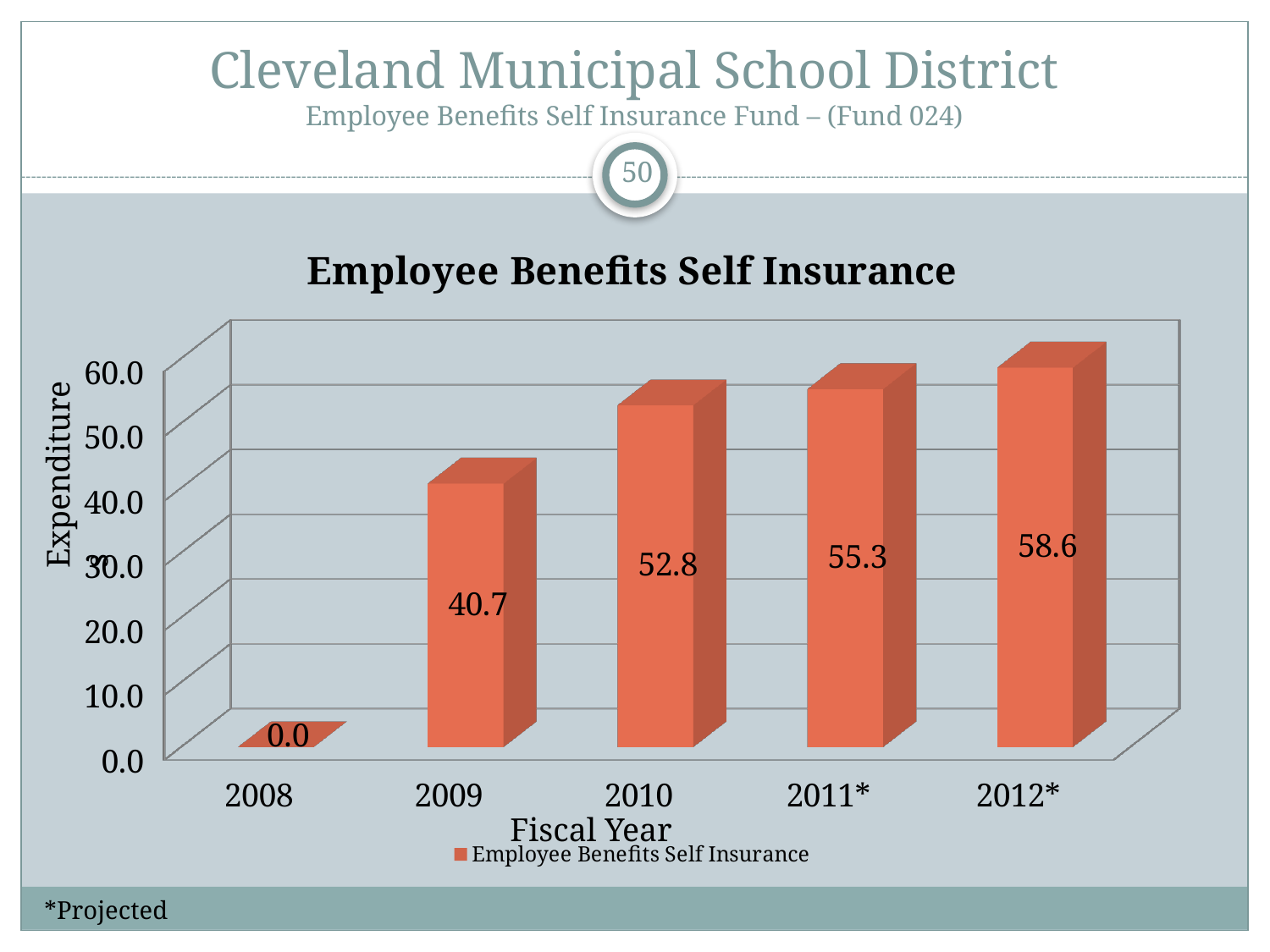
What is the expenditure value for fiscal year 2010? 52.8 Is the value for 2009 greater or less than 50.0? less How many series does the legend list? 1 What kind of chart is shown on the slide? bar chart What is the expenditure value for fiscal year 2009? 40.7 Which fiscal year has the lowest expenditure? 2008 Which is larger, the expenditure for 2009 or for 2011*? 2011* What is the expenditure value for fiscal year 2012*? 58.6 How many fiscal years are shown on the x axis? 5 Do the expenditure values rise or fall from 2008 to 2012*? rise What is the difference between the expenditure for 2011* and 2010? 2.5 Which fiscal year has the highest expenditure? 2012*